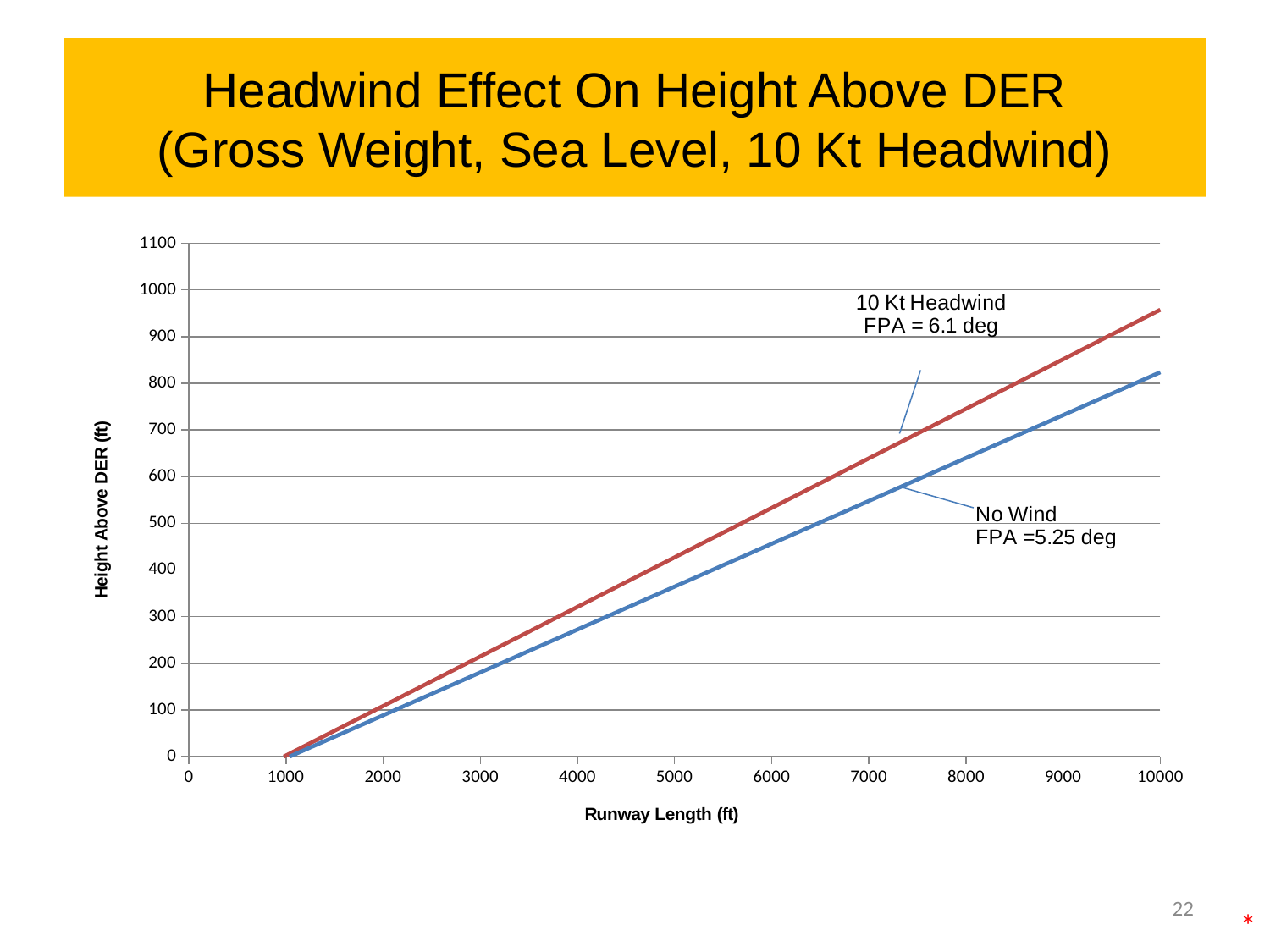
At a runway length of 10000 ft, which line has the higher height above DER, 10 Kt Headwind or No Wind? 10 Kt Headwind At a runway length of 7000 ft, which line is lower, 10 Kt Headwind or No Wind? No Wind Do the values of the No Wind line rise or fall as runway length increases? rise Is the height above DER for the No Wind line at 7000 ft runway length greater or less than 600? less How many lines are plotted on the chart? 2 Do the values of the 10 Kt Headwind line rise or fall as runway length increases? rise What kind of chart is shown on the slide? line chart Is the height above DER for the 10 Kt Headwind line at 5000 ft runway length greater or less than 400? greater What FPA value is annotated for the 10 Kt Headwind line? 6.1 deg Is the height above DER for the No Wind line at 10000 ft runway length greater or less than 900? less